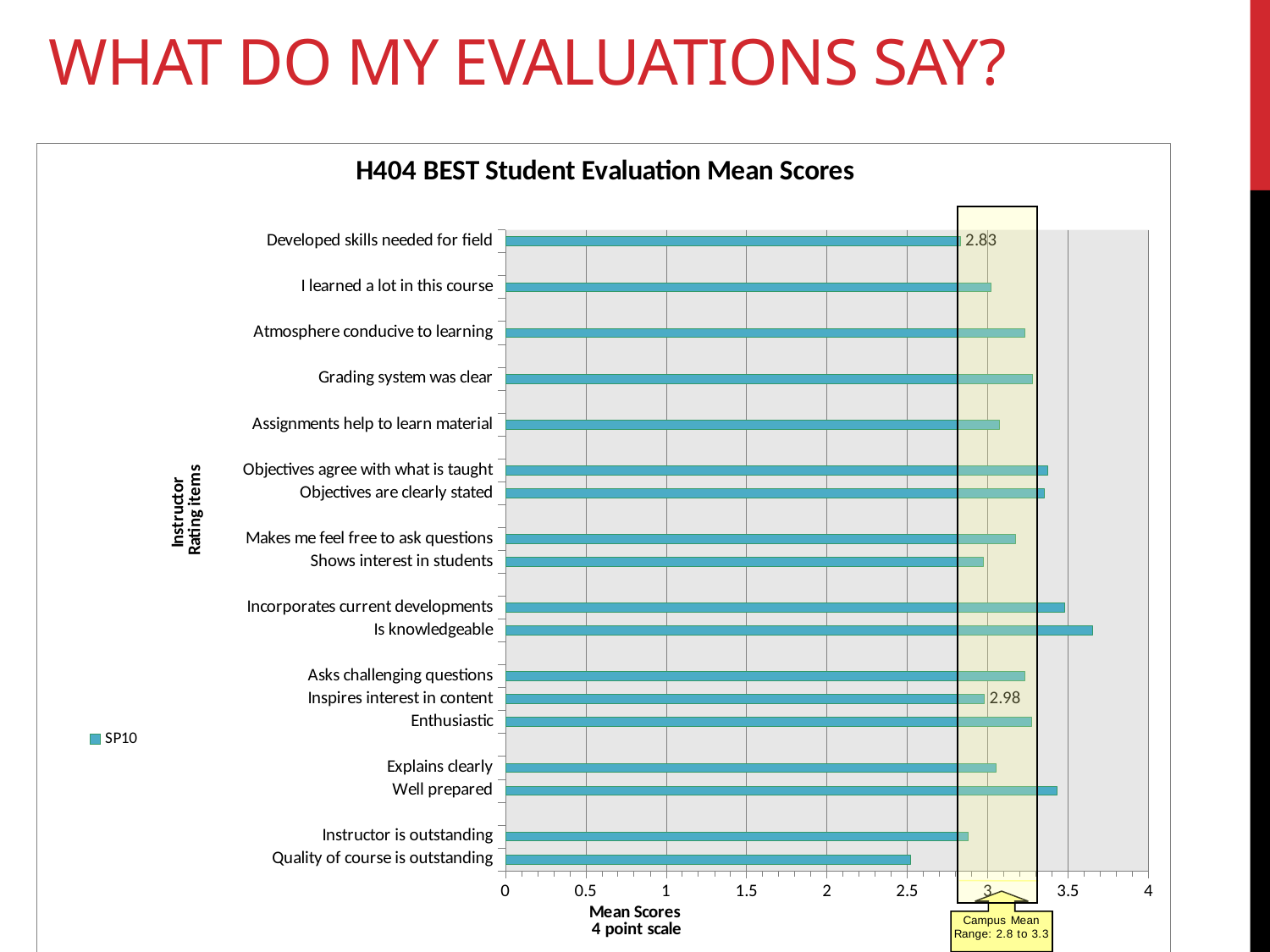
How many series does the legend list? 1 Which has a higher mean score, "Well prepared" or "Explains clearly"? Well prepared What is the mean score for "Developed skills needed for field"? 2.83 Which rating item has the lowest mean score? Quality of course is outstanding What is the difference between the mean scores for "Inspires interest in content" and "Developed skills needed for field"? 0.15 Is the mean score for "Is knowledgeable" greater or less than 3.5? greater How many rating items are plotted in the chart? 18 What is the mean score for "Inspires interest in content"? 2.98 Is the mean score for "Quality of course is outstanding" greater or less than 3? less Which rating item has the highest mean score? Is knowledgeable What type of chart is shown on the slide? Bar chart Is the mean score for "Well prepared" greater or less than 3? greater